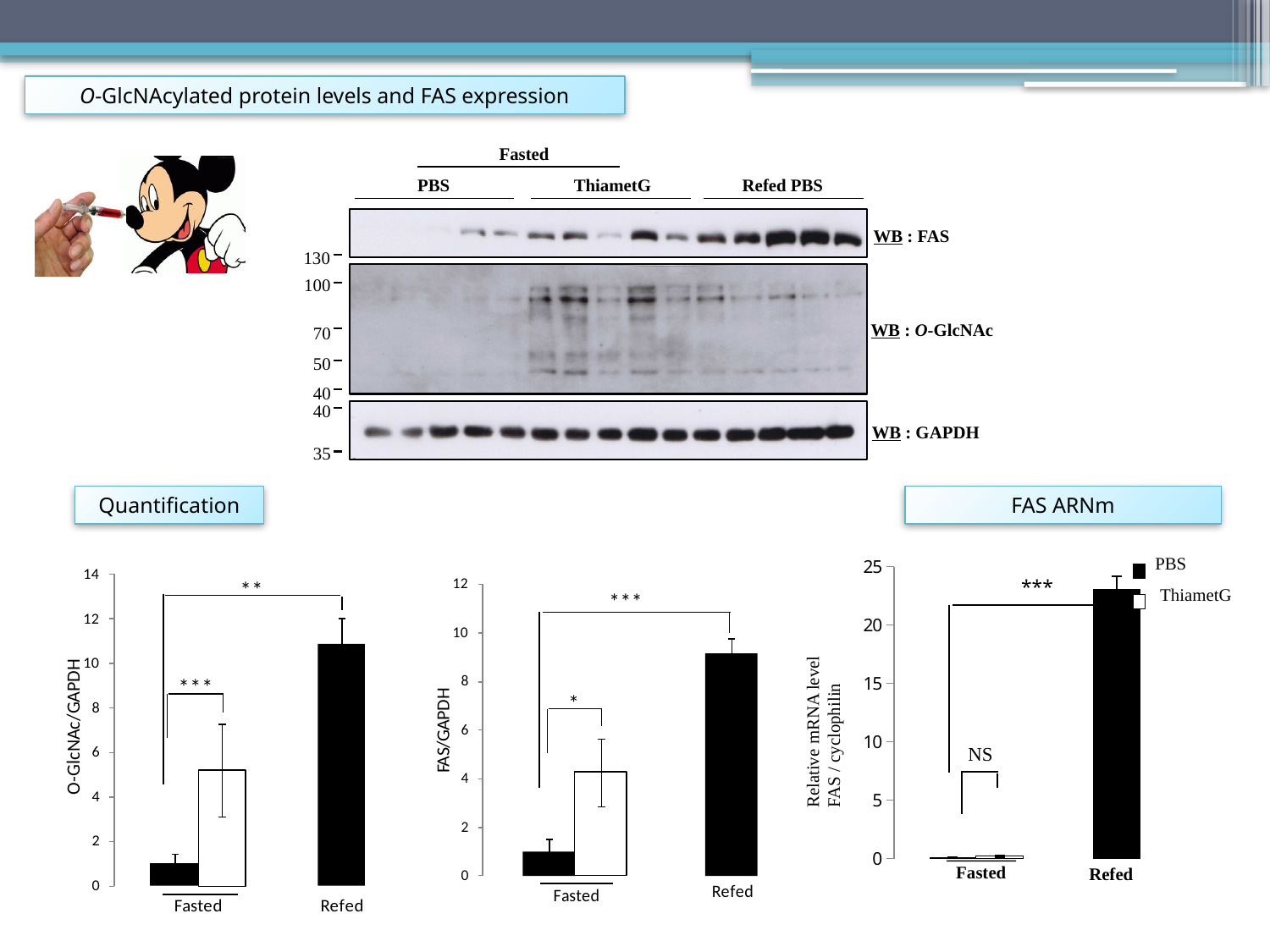
In the FAS/GAPDH chart, is the value for Refed greater or less than 8? greater How many series does the legend of the FAS ARNm chart list? 2 In the FAS/GAPDH chart, is the value for the white Fasted bar greater or less than 6? less In the FAS ARNm chart, is the value for Refed greater or less than 20? greater In the FAS ARNm chart, which is larger, Fasted or Refed? Refed What kind of chart is the FAS/GAPDH chart? bar chart What is the y-axis label of the FAS ARNm chart? Relative mRNA level FAS / cyclophilin In the O-GlcNAc/GAPDH chart, which is larger, the white Fasted bar or the Refed bar? Refed In the O-GlcNAc/GAPDH chart, which bar is the highest? Refed In the FAS/GAPDH chart, which bar is the lowest? the black Fasted bar